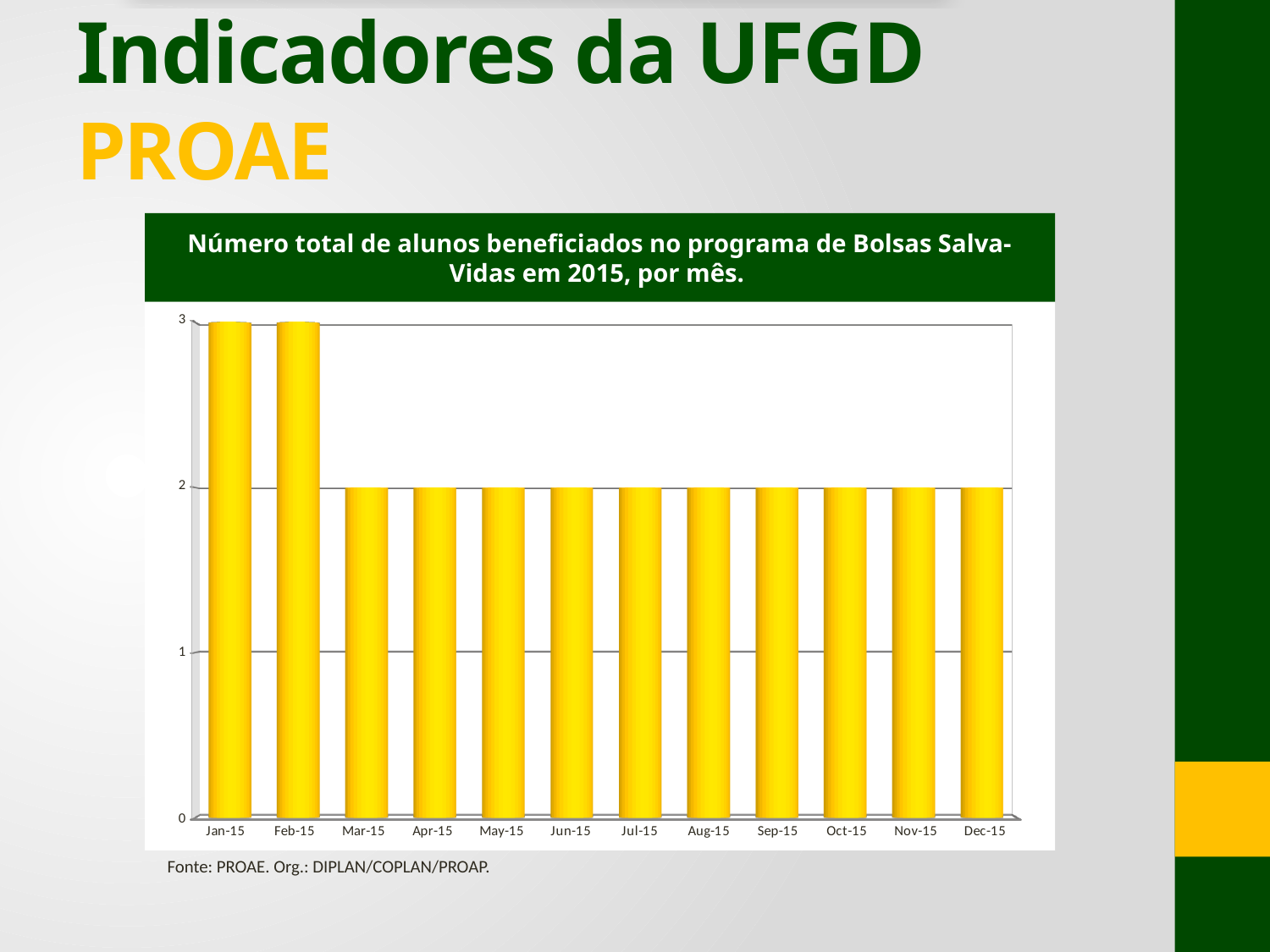
What is the value for Dec-15? 2 What is the source cited below the chart? PROAE. Org.: DIPLAN/COPLAN/PROAP. Is the value for Sep-15 greater or less than 3? less Which months have the highest value? Jan-15 and Feb-15 What is the value for Jan-15? 3 What kind of chart is shown? bar chart How many months are shown on the x axis? 12 Do the values rise or fall from Feb-15 to Mar-15? fall What is the value for Jul-15? 2 Is the value for Jan-15 greater or less than 2? greater What is the difference between the values for Feb-15 and Mar-15? 1 Which is larger, the value for Feb-15 or the value for Apr-15? Feb-15